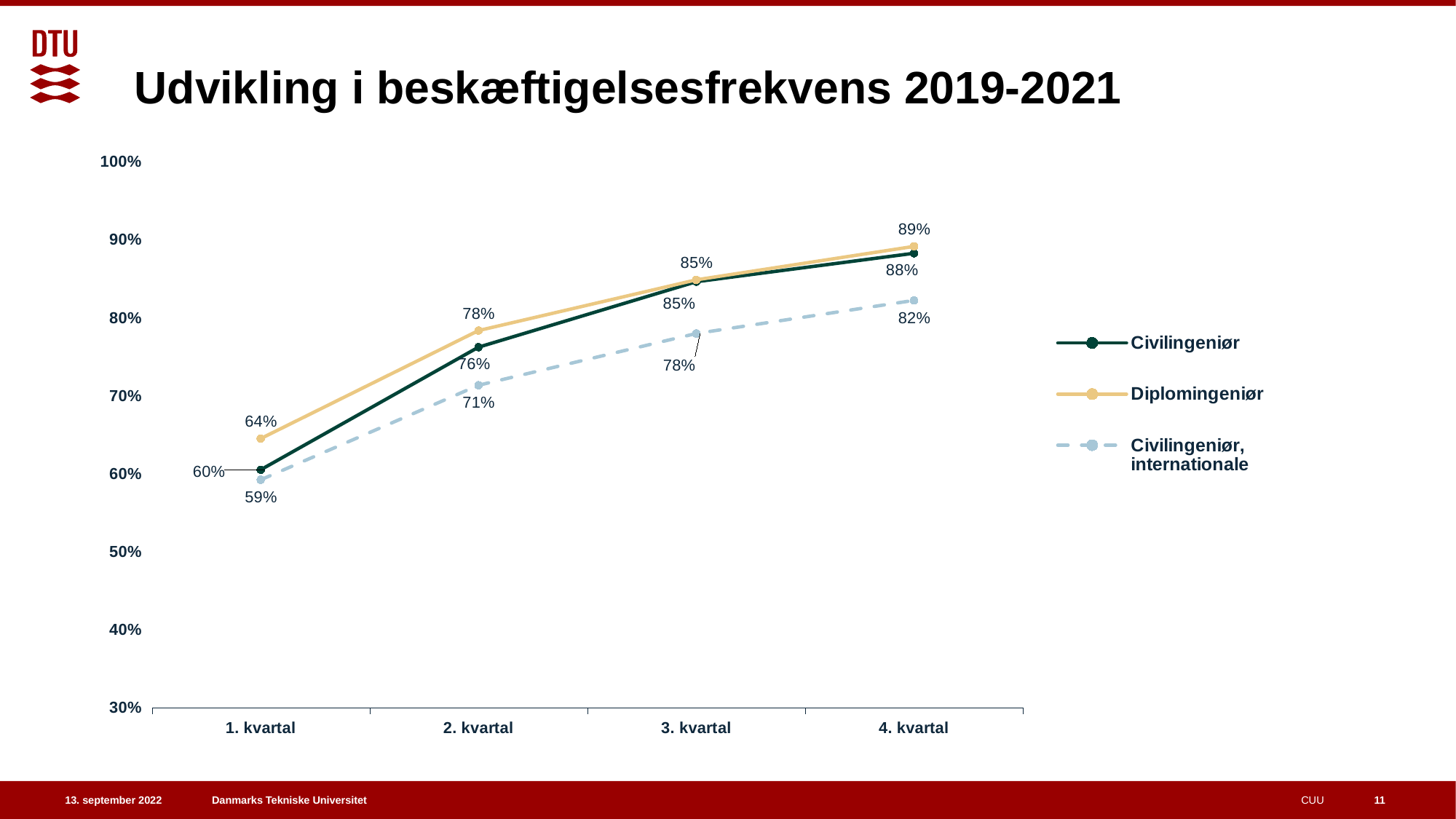
Which is larger in 2. kvartal: Diplomingeniør or Civilingeniør, internationale? Diplomingeniør How many series does the legend list? 3 What is the value for Civilingeniør in 4. kvartal? 88% What is the value for Civilingeniør, internationale in 3. kvartal? 78% Which series has the lowest value in 1. kvartal? Civilingeniør, internationale How many quarters are shown on the x axis? 4 What is the value for Civilingeniør in 2. kvartal? 76% Do the values for Civilingeniør rise or fall from 1. kvartal to 4. kvartal? rise Which series has the highest value in 4. kvartal? Diplomingeniør What is the value for Diplomingeniør in 1. kvartal? 64% What type of chart is shown on the slide? line chart What is the difference between the Diplomingeniør value in 4. kvartal and in 1. kvartal? 25%